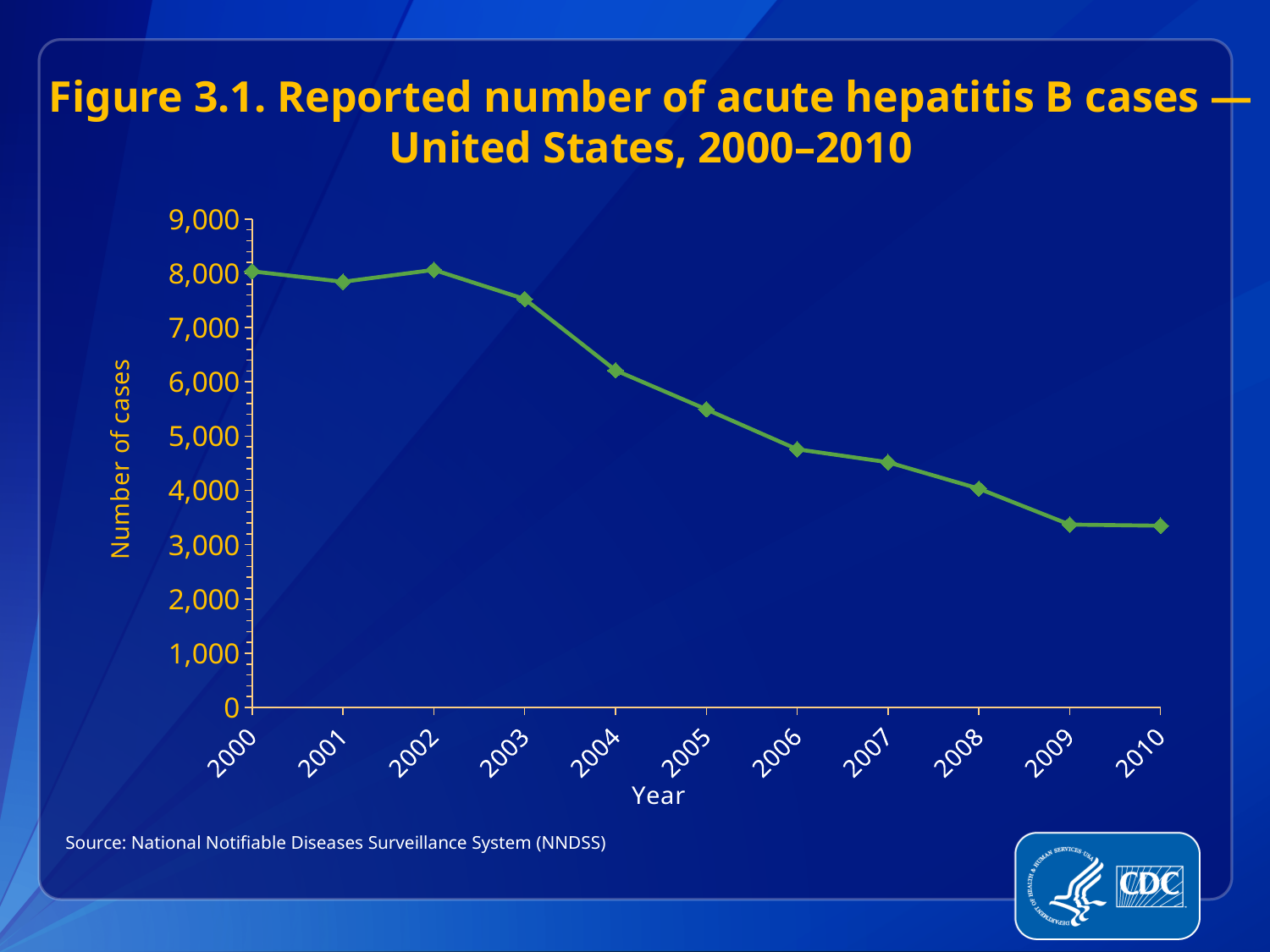
What kind of chart is shown on the slide? line chart How many years (data points) are plotted on the chart? 11 What is the label on the vertical axis of the chart? Number of cases Is the number of cases for 2004 greater or less than 6,000? greater Is the number of cases for 2003 greater or less than 7,000? greater Which year had more reported cases, 2005 or 2007? 2005 Is the number of cases for 2006 greater or less than 5,000? less Do the reported numbers of acute hepatitis B cases generally rise or fall from 2000 to 2010? fall Which year had more reported cases, 2003 or 2004? 2003 What source is cited for the chart data? National Notifiable Diseases Surveillance System (NNDSS)